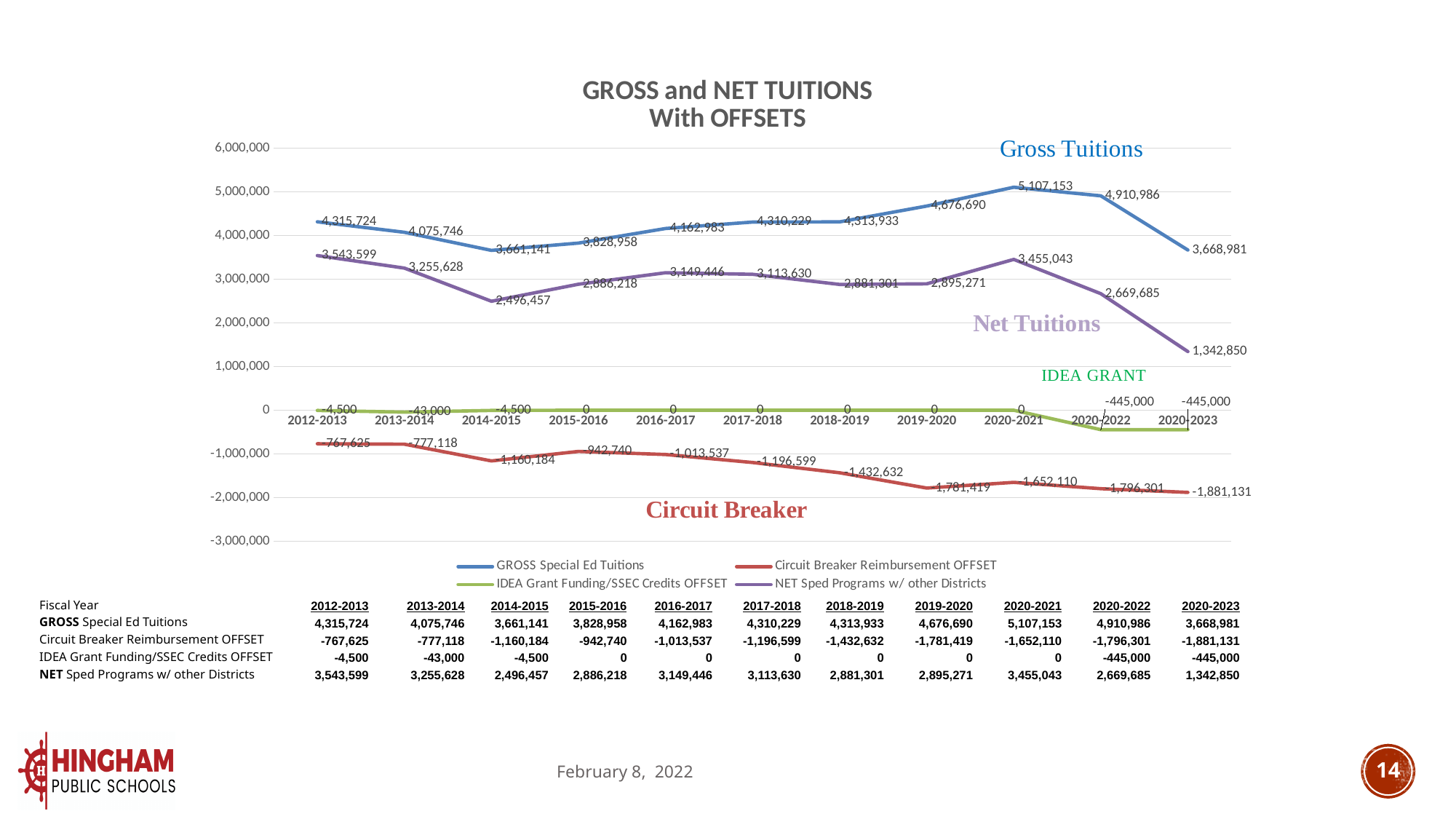
In which fiscal year is NET Sped Programs w/ other Districts highest? 2012-2013 How many fiscal years are plotted along the x axis? 11 In which fiscal year is GROSS Special Ed Tuitions lowest? 2014-2015 Which is larger, GROSS Special Ed Tuitions in 2016-2017 or in 2017-2018? 2017-2018 What is the difference between GROSS Special Ed Tuitions in 2020-2021 and 2020-2022? 196,167 What is the Circuit Breaker Reimbursement OFFSET value for 2018-2019? -1,432,632 What kind of chart is shown on the slide? line chart What is the IDEA Grant Funding/SSEC Credits OFFSET value for 2013-2014? -43,000 What is the title of the chart? GROSS and NET TUITIONS With OFFSETS What is the value of GROSS Special Ed Tuitions for 2020-2021? 5,107,153 How many series does the chart legend list? 4 Does NET Sped Programs w/ other Districts rise or fall from 2020-2021 to 2020-2023? fall